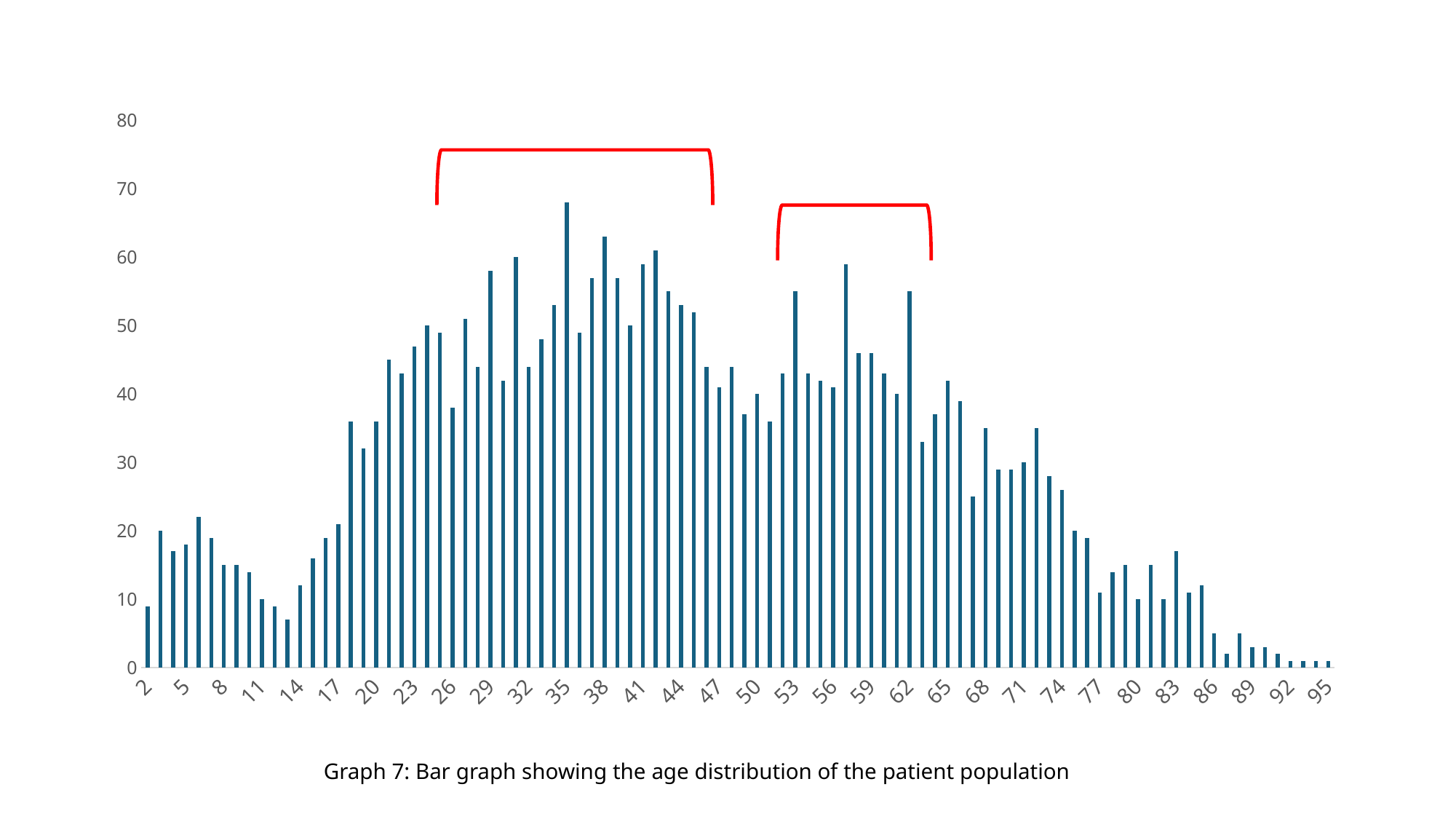
Is the value for age 29 greater or less than 50? greater Which has the larger value, age 35 or age 62? 35 Is the value for age 2 greater or less than 10? less Which labelled age has the tallest bar in the chart? 35 Is the value for age 38 greater or less than 60? greater Which has the larger value, age 20 or age 80? 20 What kind of chart is shown on the slide? Bar chart What is the caption of the chart? Graph 7: Bar graph showing the age distribution of the patient population Do the values generally rise or fall along the x axis from age 65 to age 95? fall